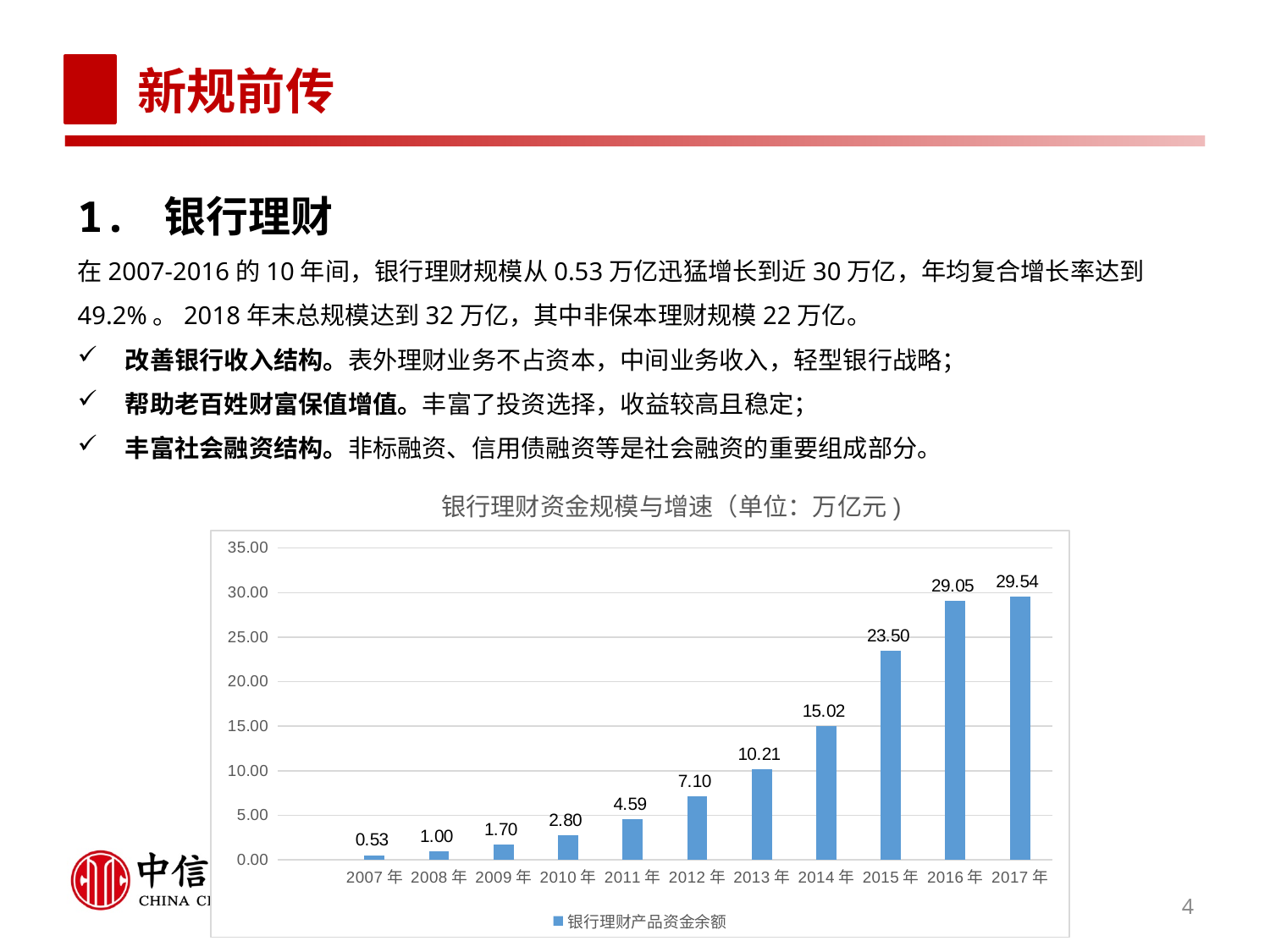
Which is larger, the value for 2012 年 or the value for 2013 年? 2013 年 What type of chart is shown on the slide? bar chart How many years are shown on the x axis of the chart? 11 Which year has the lowest value in the chart? 2007 年 What is the value for 2007 年 in the chart? 0.53 What is the value for 2014 年 in the chart? 15.02 What is the title of the chart? 银行理财资金规模与增速（单位：万亿元） Do the values rise or fall from 2007 年 to 2017 年? rise Which year has the highest value in the chart? 2017 年 How many series does the chart legend list? 1 What is the value for 2017 年 in the chart? 29.54 What is the difference between the values for 2016 年 and 2015 年? 5.55